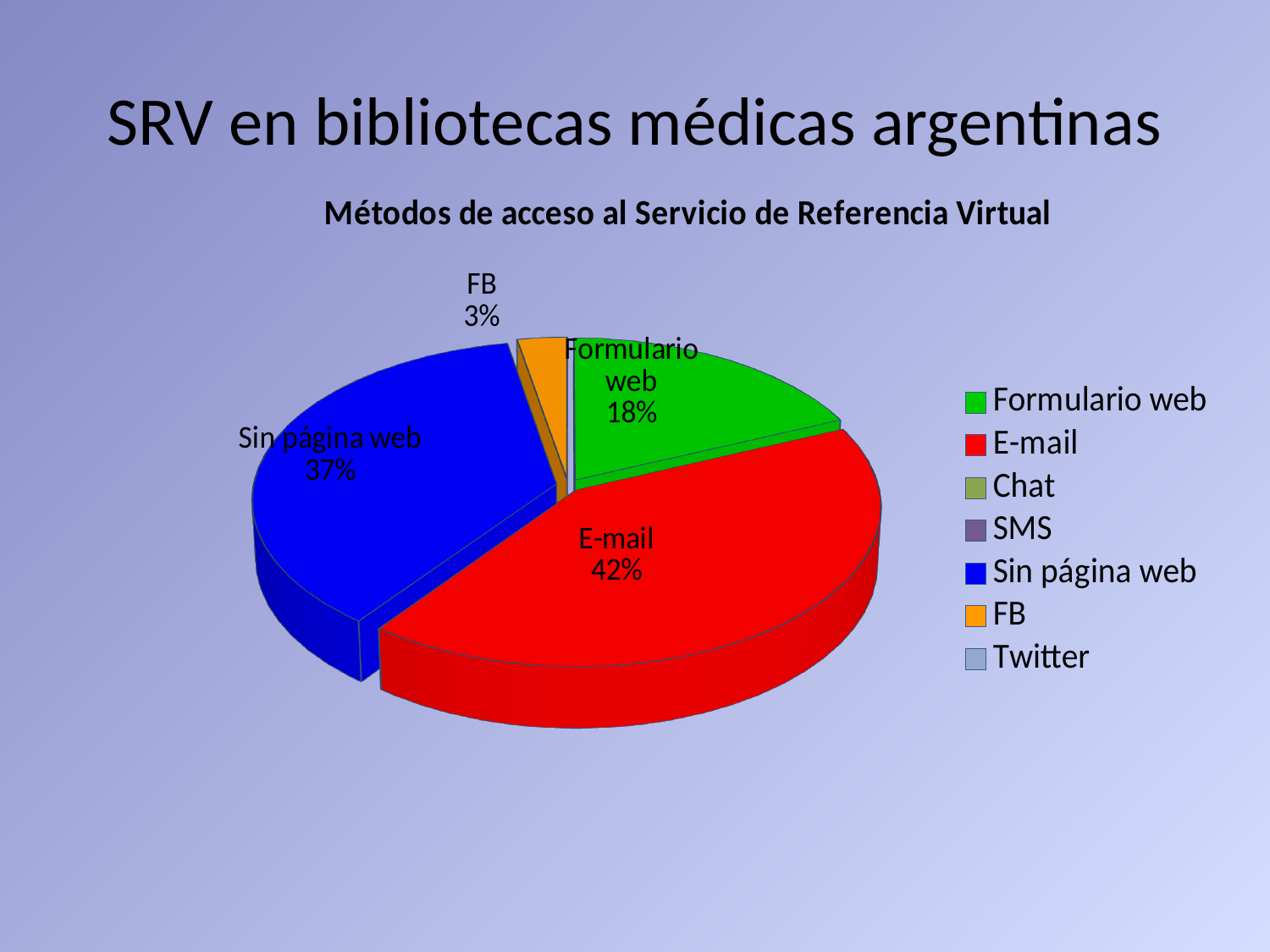
What is the title of the chart? Métodos de acceso al Servicio de Referencia Virtual What colour is the E-mail slice? Red Which category has the largest slice of the pie? E-mail What kind of chart is shown on the slide? Pie chart Among the slices with a printed percentage, which is the smallest? FB What percentage is shown for FB? 3% Which is larger, the Formulario web slice or the FB slice? Formulario web What percentage is shown for Sin página web? 37% By how many percentage points does E-mail exceed Sin página web? 5 What percentage of the pie does E-mail account for? 42% What percentage is shown for Formulario web? 18% How many entries does the legend list? 7